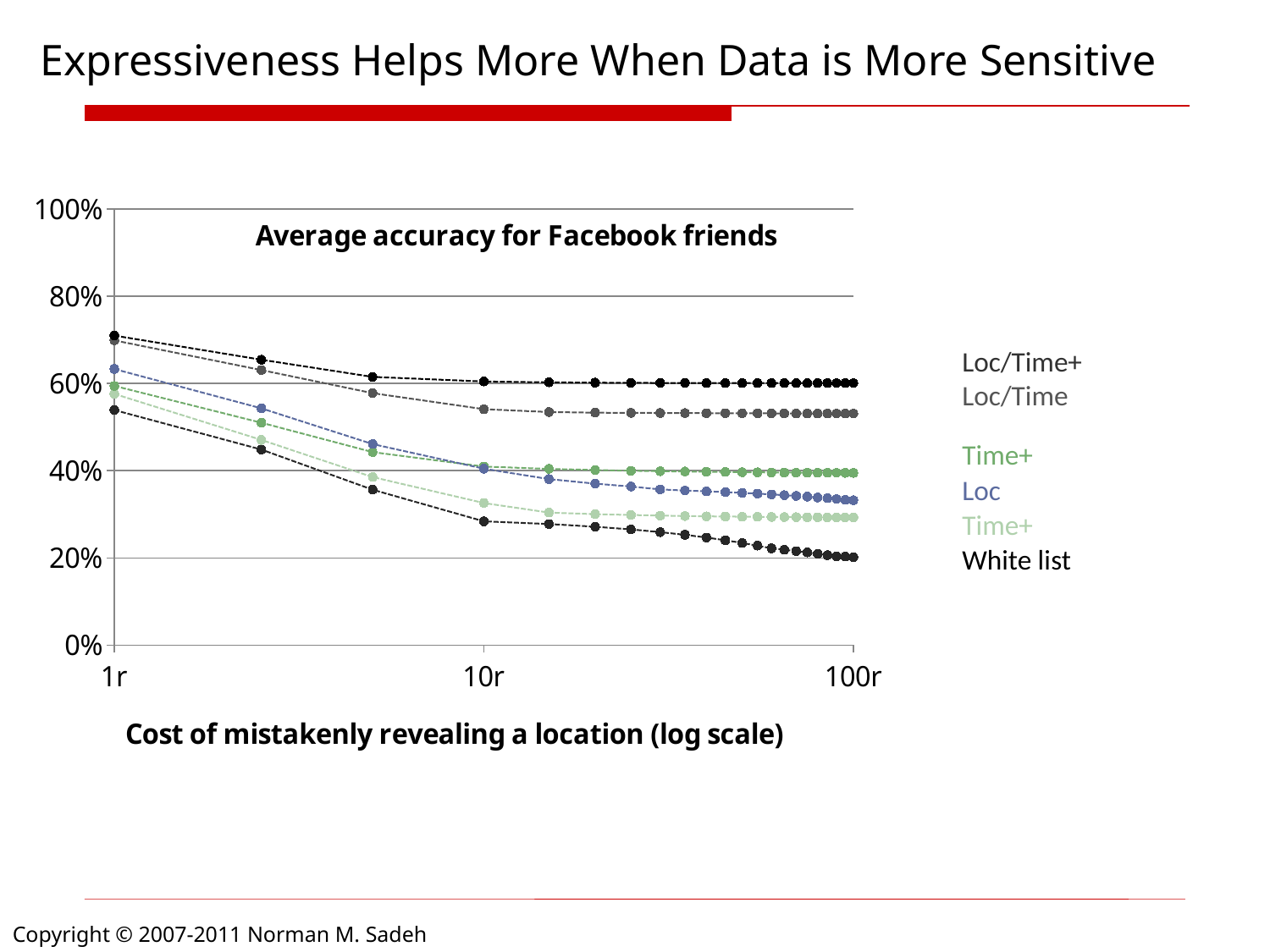
What is the title of the chart? Average accuracy for Facebook friends Do the accuracy values rise or fall as the cost of mistakenly revealing a location increases? fall What kind of chart is shown on the slide? line chart Is the value for White list at 100r greater or less than 40%? less Which series has the lowest accuracy at 100r? White list At 100r, which is larger: the value for Loc or the value for Loc/Time? Loc/Time Is the value for Loc/Time+ at 100r greater or less than 40%? greater Which series has the highest accuracy at 100r? Loc/Time+ Is the value for Loc/Time at 1r greater or less than 60%? greater How many series does the legend list? 6 What is the label of the x axis? Cost of mistakenly revealing a location (log scale) At 10r, which is larger: the value for Loc/Time+ or the value for White list? Loc/Time+